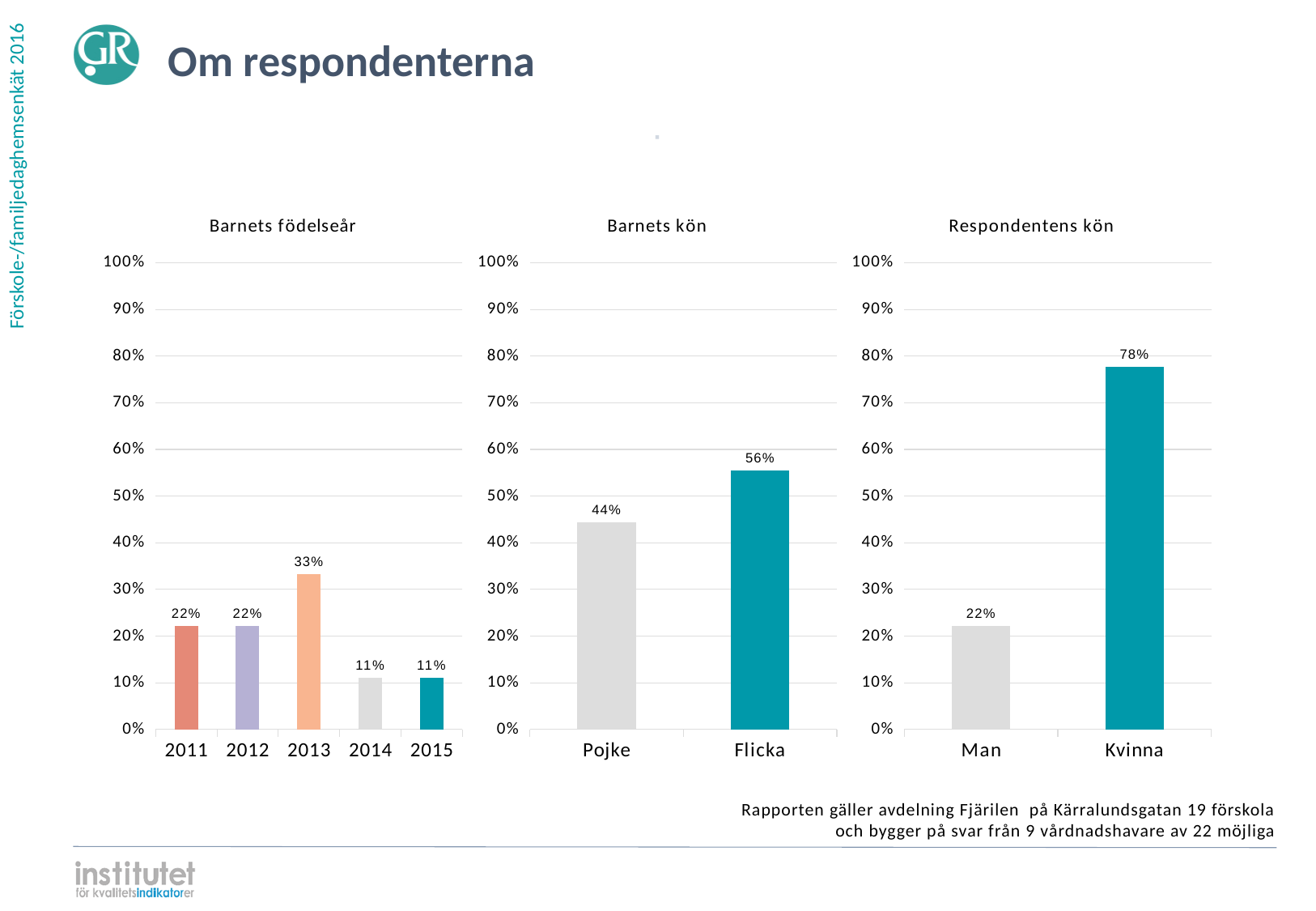
What kind of chart is the 'Respondentens kön' chart? Bar chart In the 'Barnets kön' chart, what is the value for Pojke? 44% In the 'Respondentens kön' chart, which category has the lowest value? Man In the 'Barnets födelseår' chart, how many years are shown on the x axis? 5 In the 'Barnets födelseår' chart, what is the value for 2013? 33% In the 'Barnets födelseår' chart, which year has the highest value? 2013 In the 'Barnets födelseår' chart, is the value for 2015 greater or less than 20%? less In the 'Respondentens kön' chart, what is the difference between Kvinna and Man? 56% In the 'Barnets kön' chart, what is the difference between Flicka and Pojke? 12% In the 'Barnets födelseår' chart, what is the difference between the values for 2013 and 2014? 22% In the 'Respondentens kön' chart, what is the value for Kvinna? 78% In the 'Barnets kön' chart, which category is larger, Pojke or Flicka? Flicka